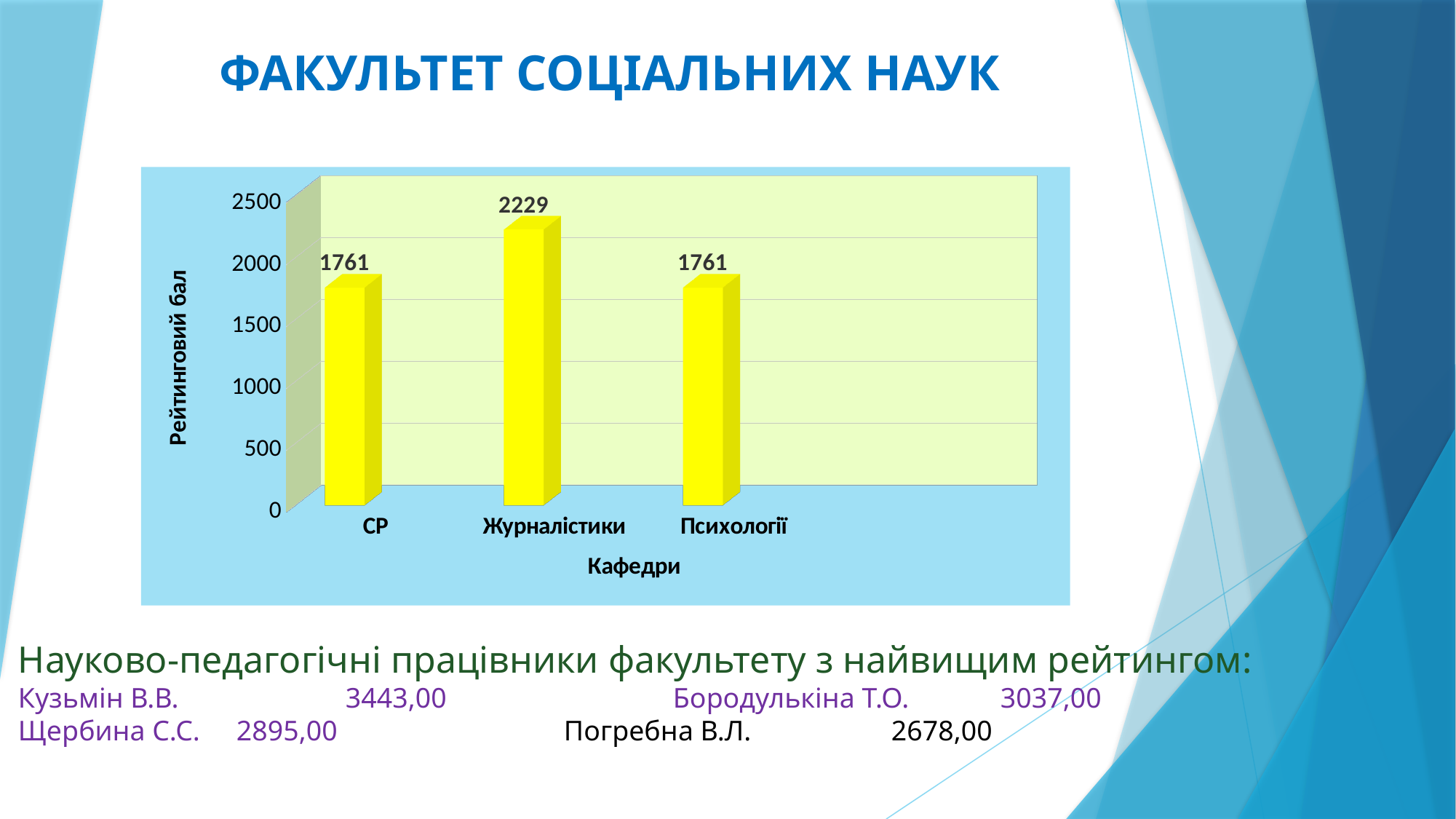
What is the rating score for the Психології department? 1761 How many departments (кафедри) are shown on the chart? 3 What kind of chart is shown on the slide? bar chart What is the label of the vertical axis of the chart? Рейтинговий бал What is the label of the horizontal axis of the chart? Кафедри What is the rating score (Рейтинговий бал) for the СР department? 1761 What is the difference between the rating scores of Журналістики and СР? 468 What is the rating score for the Журналістики department? 2229 Is the value for Журналістики greater or less than 2000? greater Is the value for СР greater or less than 2000? less Which has a larger rating score, Журналістики or Психології? Журналістики Which department has the highest rating score? Журналістики